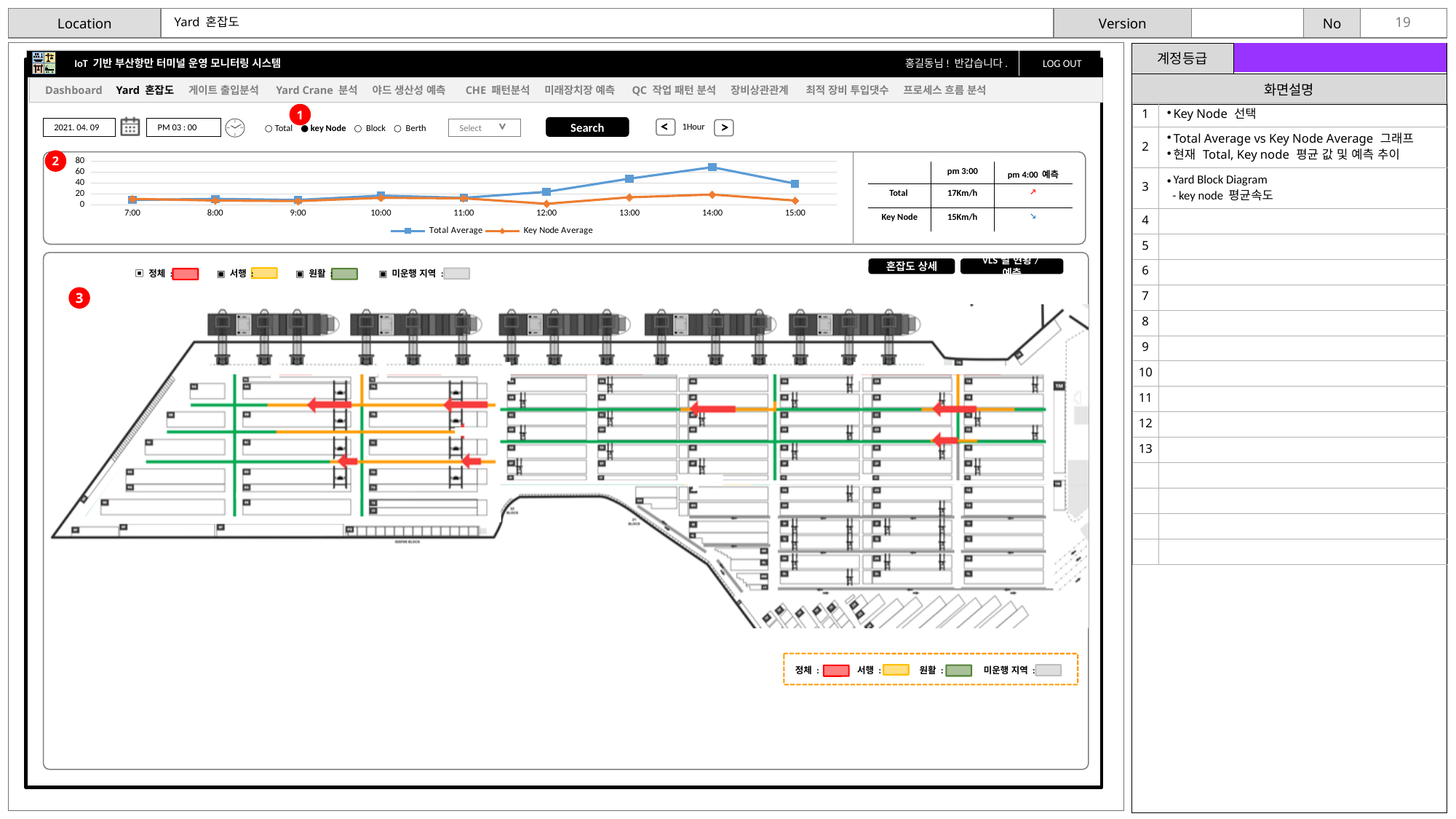
Is the Key Node Average value at 14:00 greater or less than 40? less What are the two series named in the line chart's legend? Total Average and Key Node Average How many series does the legend of the line chart list? 2 What kind of chart is shown in the top panel of the slide? line chart How many time points are shown along the x axis of the line chart? 9 At which time does the Total Average series reach its highest value? 14:00 Is the Total Average value at 13:00 greater or less than 20? greater Does the Total Average series rise or fall between 12:00 and 14:00? rise Is the Total Average value at 14:00 greater or less than 40? greater What colour is the Total Average line in the chart? blue At which time does the Key Node Average series reach its highest value? 14:00 At 14:00, which series has the larger value, Total Average or Key Node Average? Total Average